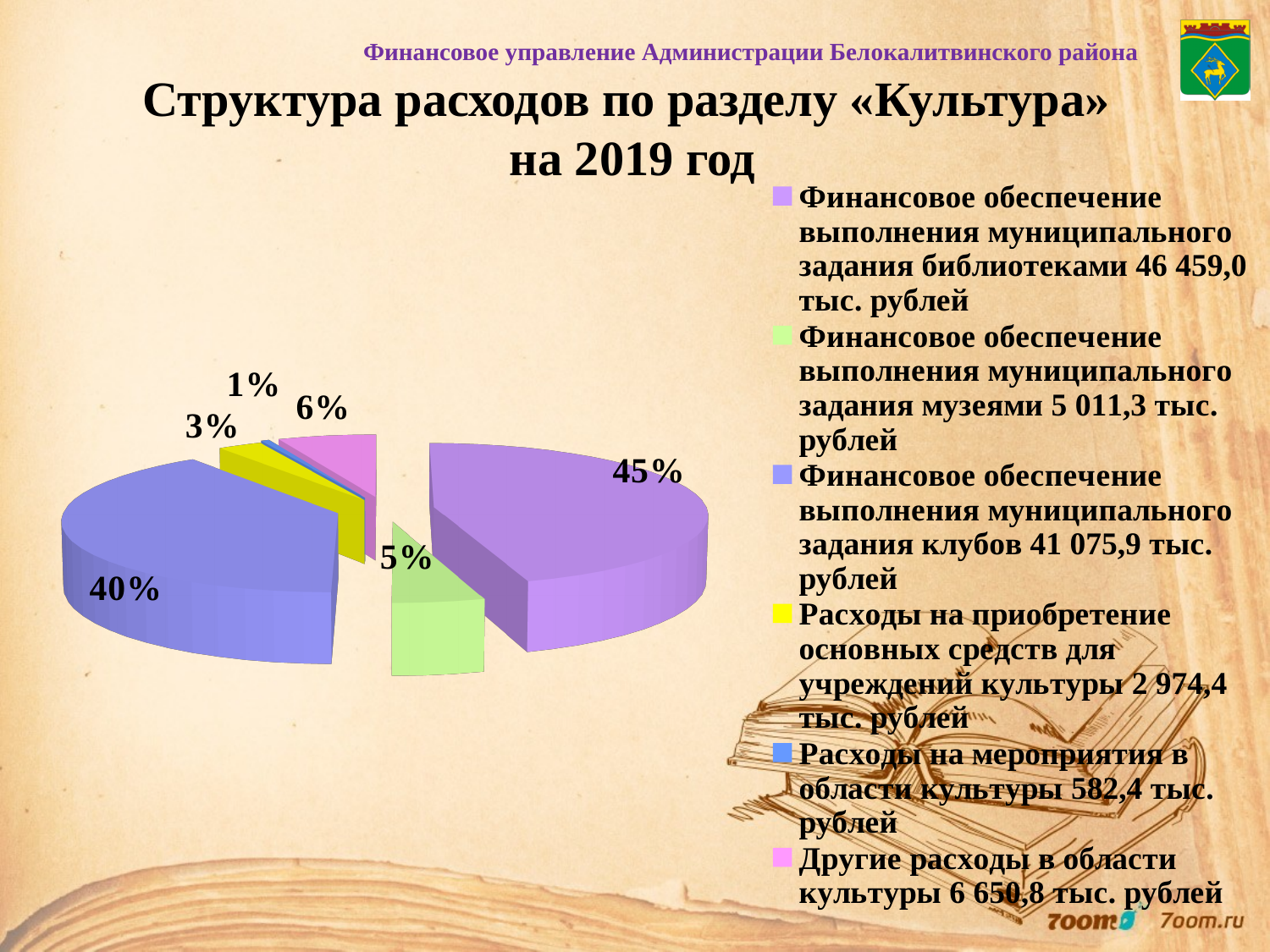
What share of the pie is the slice for other expenses in the field of culture (Другие расходы в области культуры)? 6% Which legend category has the smallest share of the pie? Расходы на мероприятия в области культуры What kind of chart is shown on the slide? pie chart What share of the pie is the slice for financial support of the municipal task for museums (Финансовое обеспечение выполнения муниципального задания музеями)? 5% What is the title of the chart on the slide? Структура расходов по разделу «Культура» на 2019 год How many slices does the pie chart have? 6 What share of the pie is the slice for financial support of the municipal task for clubs (Финансовое обеспечение выполнения муниципального задания клубов)? 40% How many entries does the legend list? 6 Which slice is larger: the one for other expenses in the field of culture (6%) or the one for purchase of fixed assets for cultural institutions (3%)? Другие расходы в области культуры What is the difference in percentage points between the libraries slice (45%) and the clubs slice (40%)? 5 Which legend category has the largest share of the pie? Финансовое обеспечение выполнения муниципального задания библиотеками